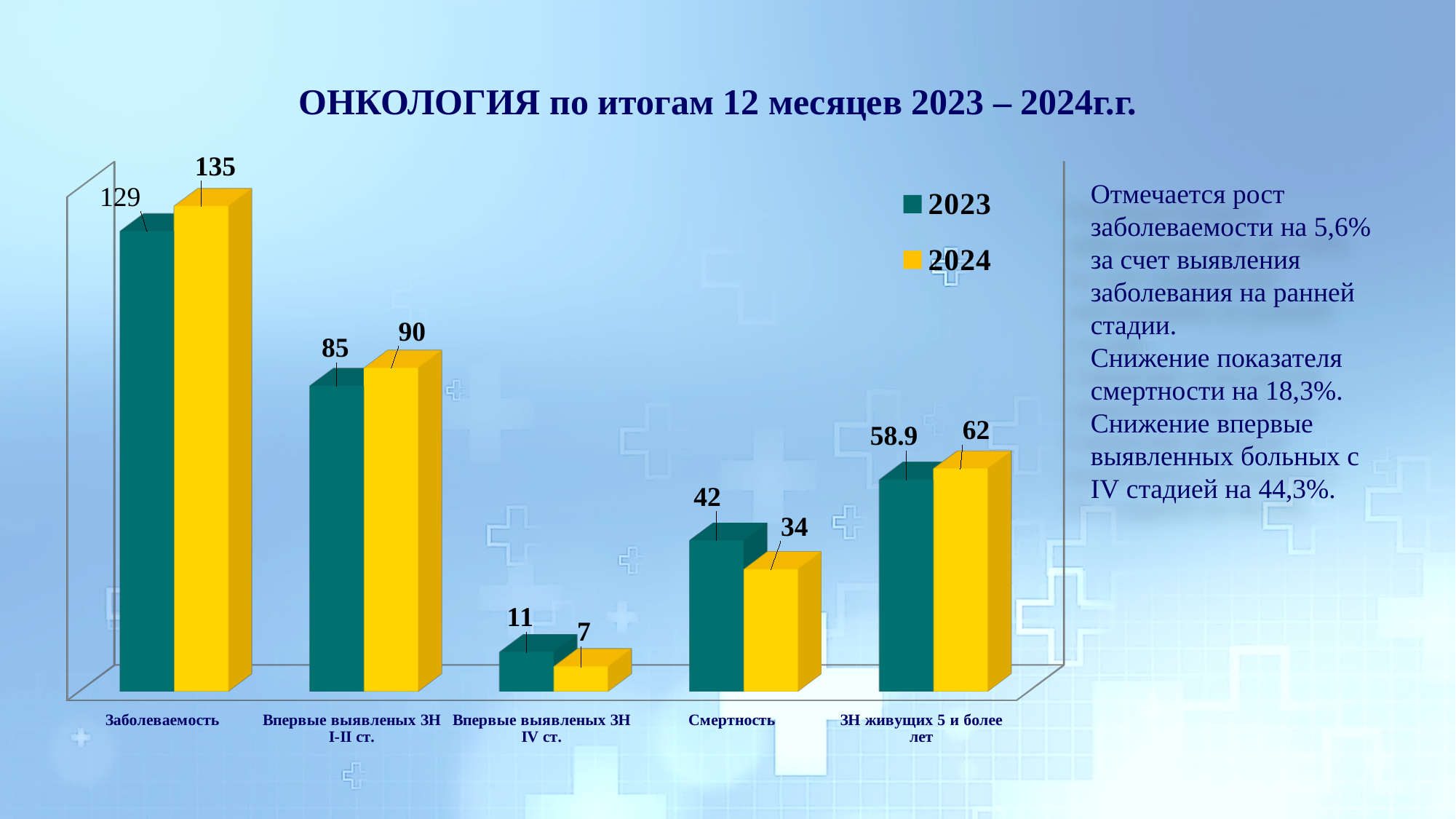
Which category has the highest 2024 value? Заболеваемость Which category has the lowest 2023 value? Впервые выявленых ЗН IV ст. What is the difference between the 2024 and 2023 values for Заболеваемость? 6 How many categories are shown on the x axis? 5 What kind of chart is shown on the slide? Bar chart How many series does the legend list? 2 What is the 2024 value for Впервые выявленых ЗН IV ст.? 7 What is the 2024 value for Заболеваемость? 135 What is the difference between the 2023 and 2024 values for Смертность? 8 For Впервые выявленых ЗН I-II ст., which year has the larger value, 2023 or 2024? 2024 What is the 2023 value for ЗН живущих 5 и более лет? 58.9 What is the 2023 value for Смертность? 42